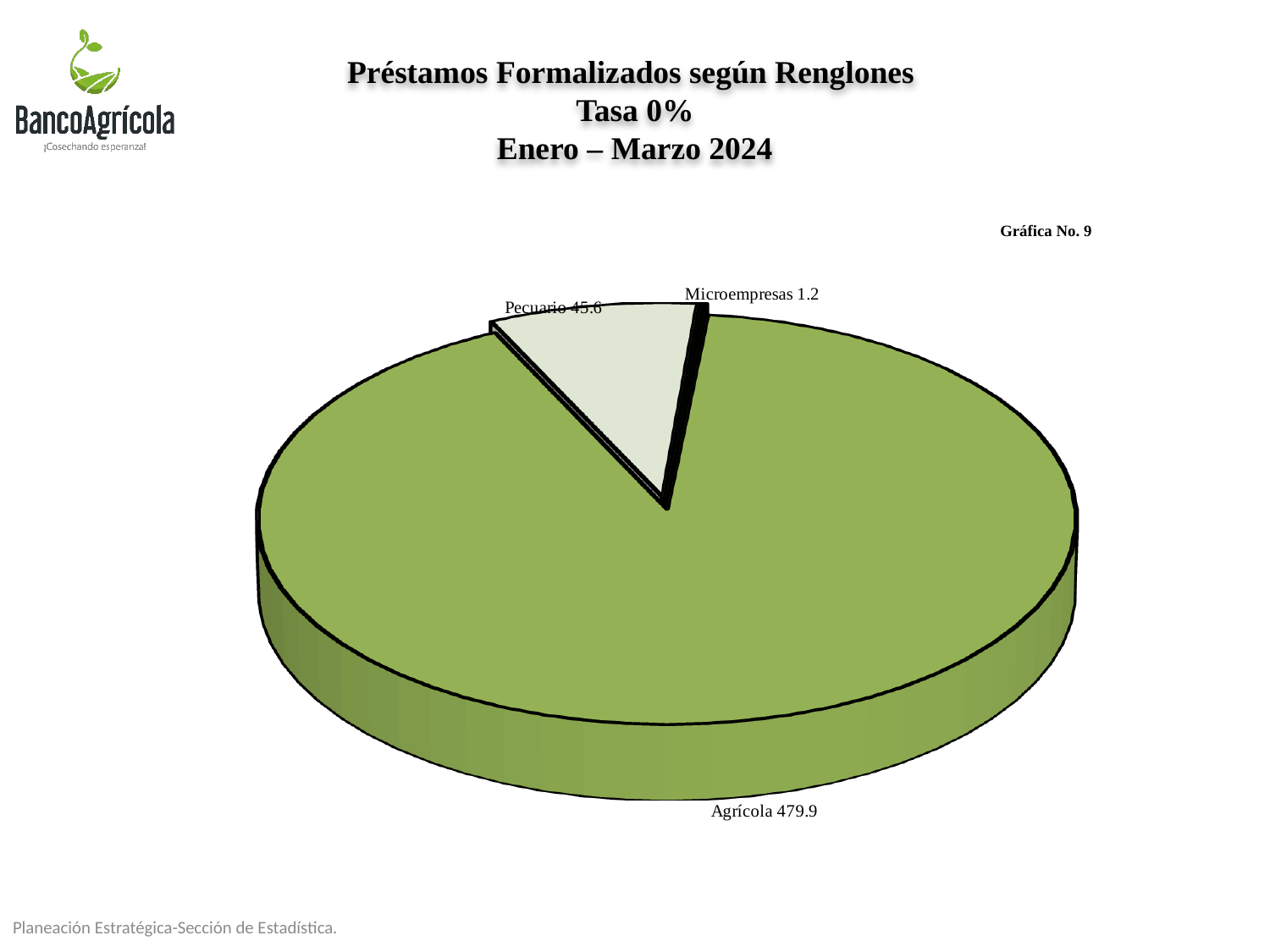
Which category has the smallest slice of the pie? Microempresas What is the value for Microempresas? 1.2 What is the value for Pecuario? 45.6 What is the value for Agrícola? 479.9 Which category has the largest slice of the pie? Agrícola How many categories are shown in the pie chart? 3 What is the difference between the values for Agrícola and Pecuario? 434.3 Which is larger, the value for Pecuario or the value for Microempresas? Pecuario What is the total of all the slices in the pie chart? 526.7 What type of chart is shown on the slide? Pie chart What is the title of the chart? Préstamos Formalizados según Renglones Tasa 0% Enero – Marzo 2024 What is the difference between the values for Pecuario and Microempresas? 44.4